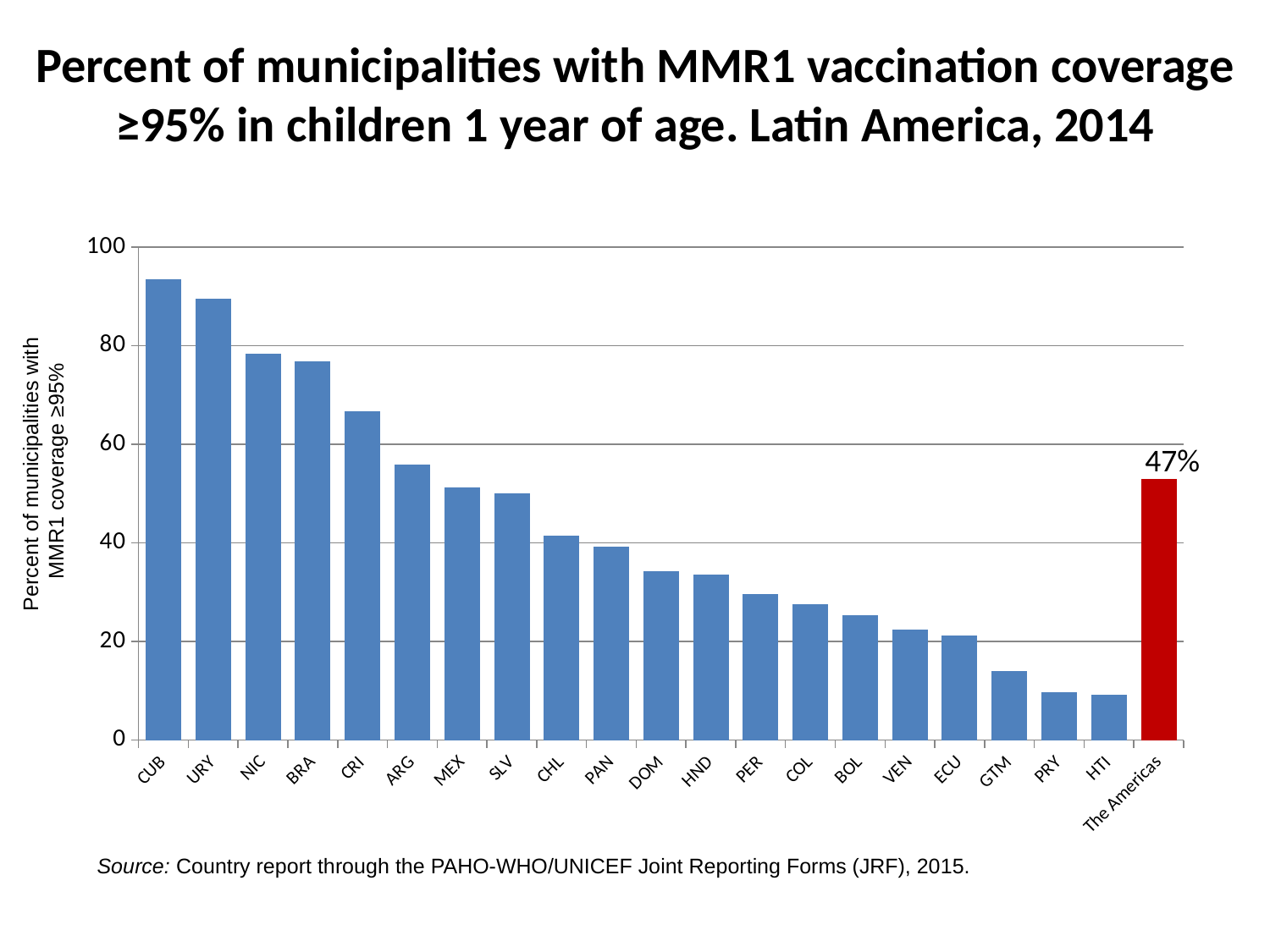
How many bars are plotted in the chart, including The Americas? 21 Do the country values rise or fall from left to right across the x axis (from CUB to HTI)? fall Is the value for ARG greater or less than 60? less Which country has the highest percent of municipalities with MMR1 coverage ≥95%? CUB Is the value for CUB greater or less than 80? greater What is the value printed for The Americas? 47% Which has a higher value, BRA or CRI? BRA Is the value for GTM greater or less than 20? less Which has a higher value, DOM or MEX? MEX What kind of chart is shown on the slide? bar chart What colour is the bar for The Americas? red